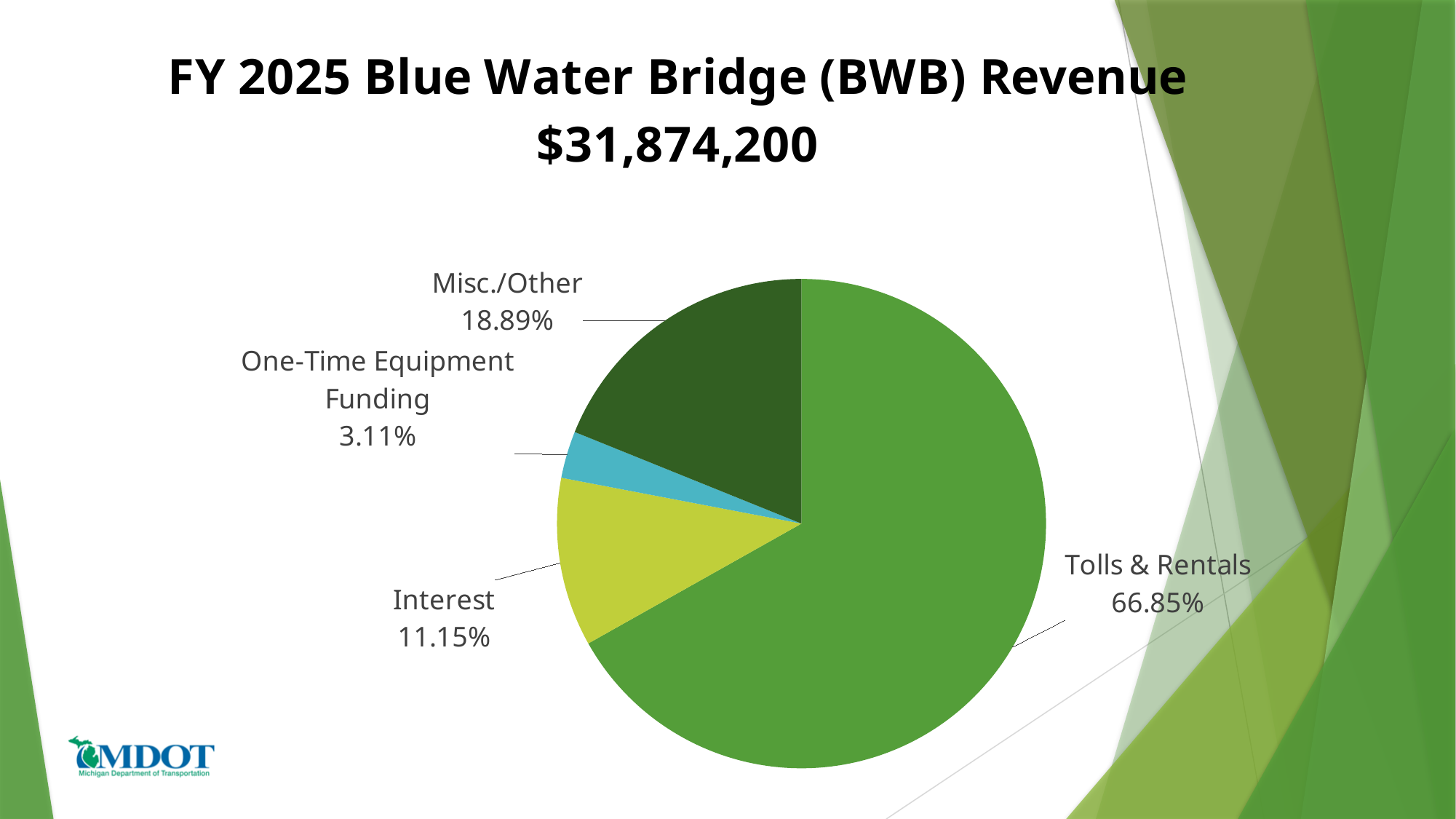
What percentage of the pie is Misc./Other? 18.89% What colour is the One-Time Equipment Funding slice? Blue Which category has the smallest share of the pie? One-Time Equipment Funding What is the difference in percentage points between Tolls & Rentals and Misc./Other? 47.96 What percentage does One-Time Equipment Funding represent? 3.11% What is the share for Interest? 11.15% How many categories are shown in the pie chart? 4 Which category has the largest share of the pie? Tolls & Rentals Which is larger, the share for Misc./Other or the share for Interest? Misc./Other What total revenue amount is shown in the slide title? $31,874,200 What kind of chart is shown on the slide? Pie chart